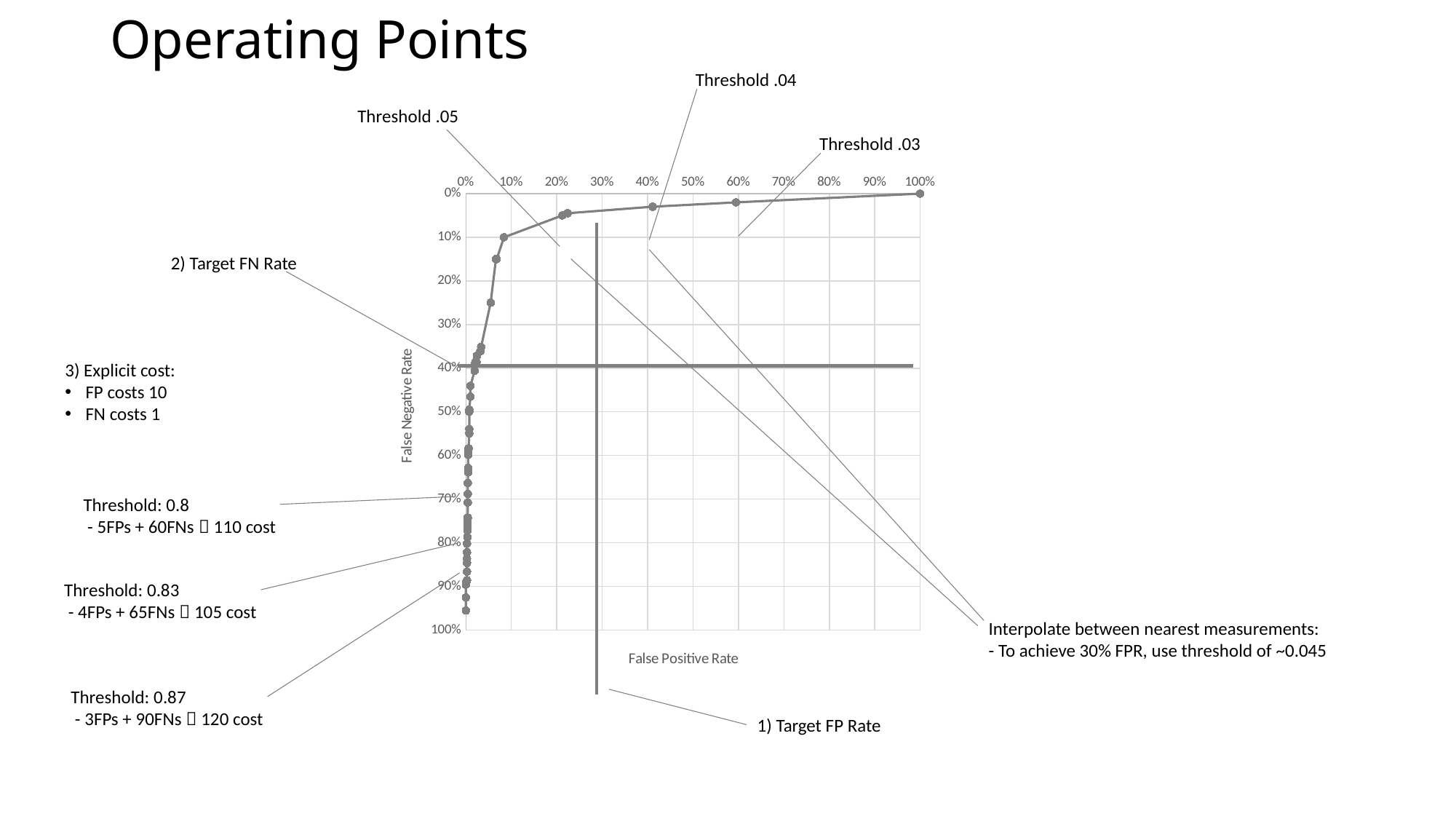
What is the label of the chart's horizontal axis? False Positive Rate Is the False Negative Rate of the point at 40% False Positive Rate greater or less than 10%? less According to the annotation, what threshold should be used to achieve a 30% FPR? ~0.045 As the False Positive Rate increases along the x axis, does the False Negative Rate rise or fall? fall What is the label of the chart's vertical axis? False Negative Rate What is the False Negative Rate of the plotted point at 100% False Positive Rate? 0% At what False Negative Rate is the horizontal 'Target FN Rate' line drawn on the chart? 40% What is the highest value shown on the chart's horizontal axis? 100% Is the False Negative Rate of the point at 60% False Positive Rate greater or less than 10%? less According to the annotations, what is the cost at threshold 0.83? 105 Which plotted point has the lowest False Negative Rate: the one at 100% False Positive Rate or the one at 60% False Positive Rate? the one at 100% False Positive Rate